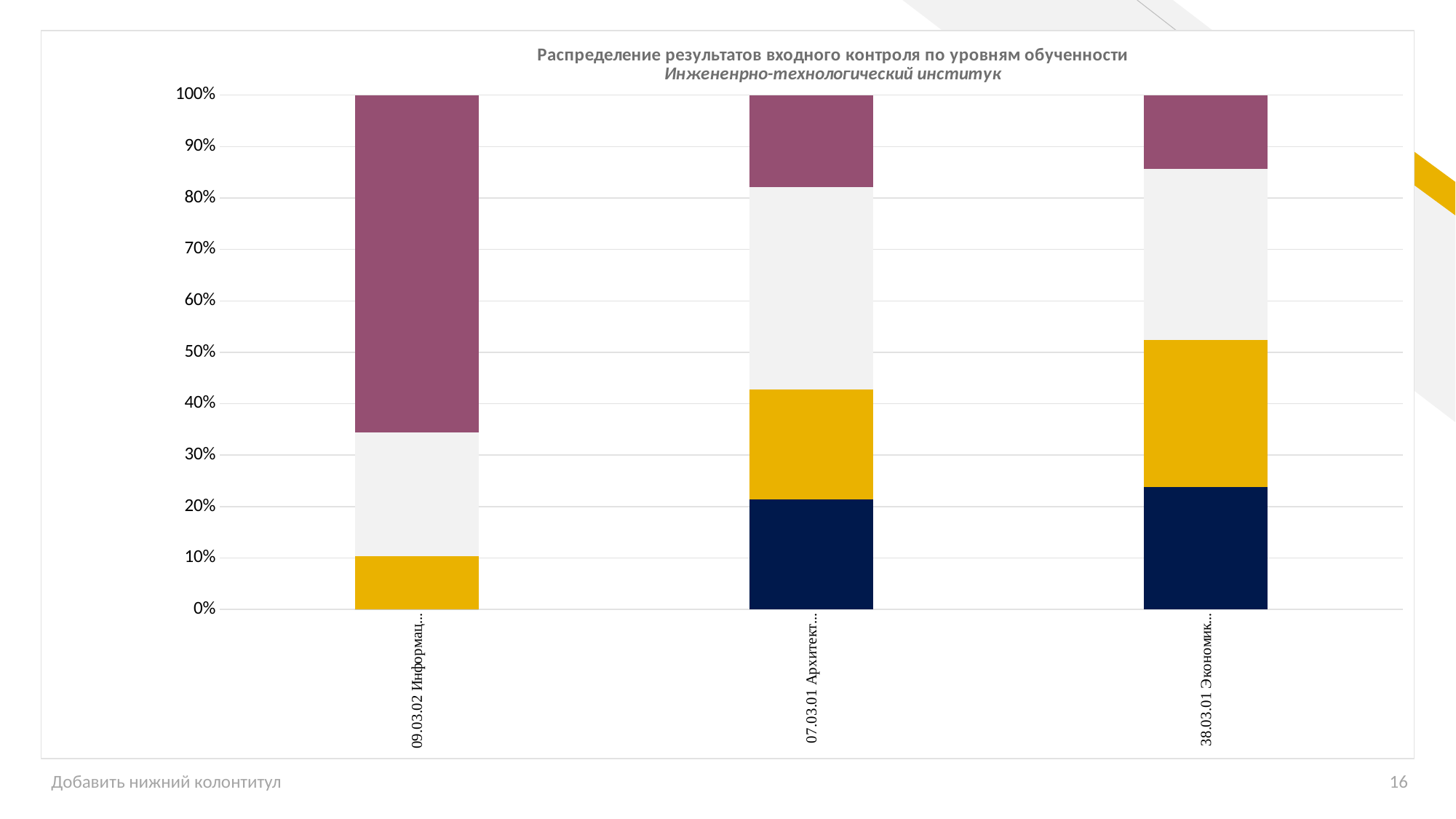
Is the dark navy (bottom) segment for 38.03.01 Экономик... greater or less than 20%? greater Which category has the largest purple (top) segment? 09.03.02 Информац... How many categories (bars) are shown on the x axis? 3 What is the title of the chart? Распределение результатов входного контроля по уровням обученности Инжененрно-технологический институк Which category has the largest yellow segment? 38.03.01 Экономик... Is the purple (top) segment for 09.03.02 Информац... greater or less than 50%? greater What is the total height of the stacked bar for 09.03.02 Информац...? 100% Is the light gray segment for 07.03.01 Архитект... greater or less than 30%? greater What kind of chart is shown on the slide? stacked bar chart How many differently coloured segments make up the bar for 07.03.01 Архитект...? 4